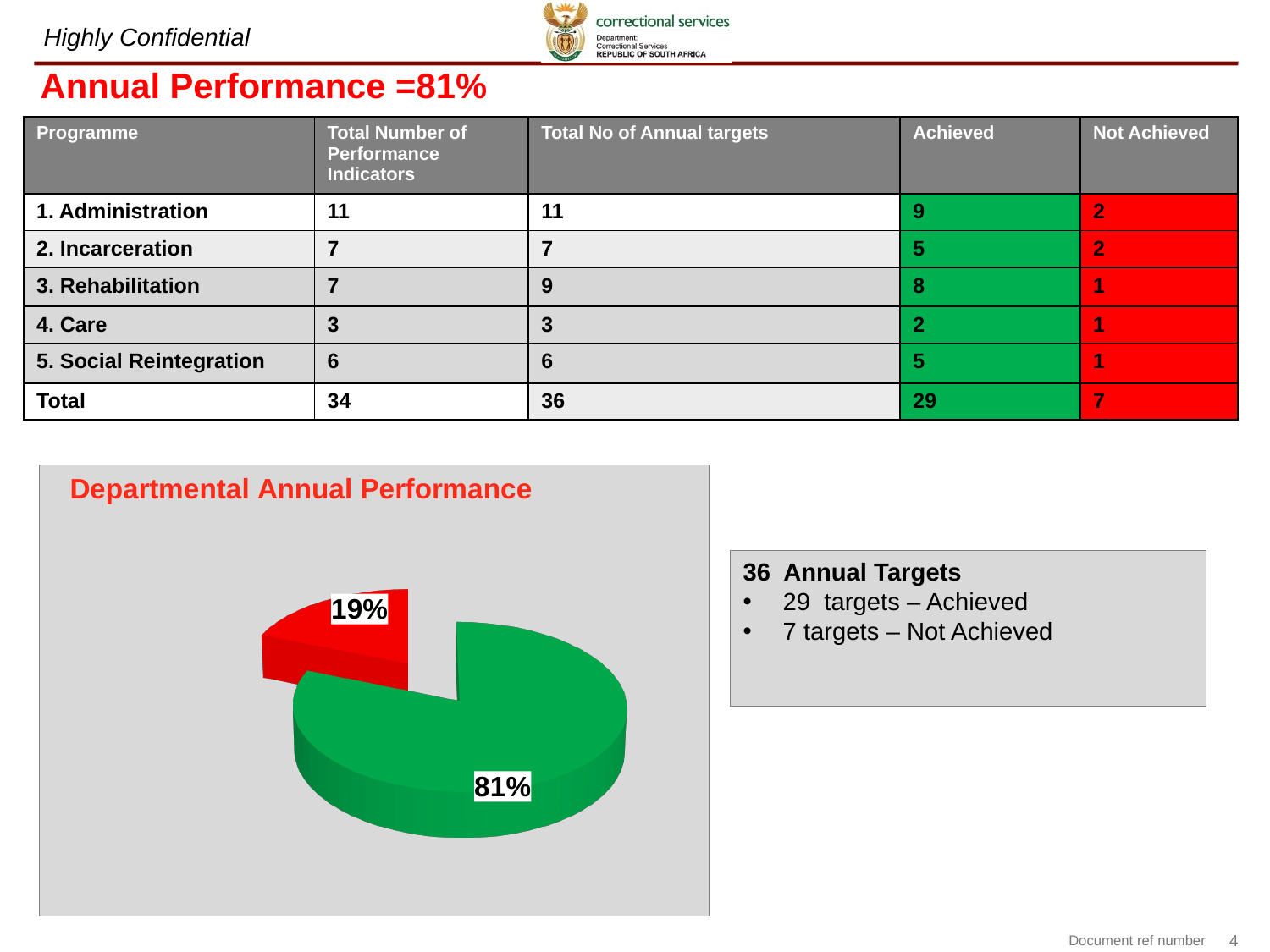
What percentage is shown on the green slice of the pie chart? 81% What is the title of the chart on the slide? Departmental Annual Performance What colour is the slice labelled 81% in the pie chart? green What is the difference in percentage points between the green slice and the red slice of the pie chart? 62 Is the green slice of the pie chart larger or smaller than the red slice? larger Which slice of the pie chart is the smallest, the green one or the red one? red How many slices does the pie chart have? 2 What share of the pie does the red slice represent? 19% Which slice of the pie chart is the largest, the green one or the red one? green What kind of chart is shown under the title "Departmental Annual Performance"? pie chart What percentage is shown on the red slice of the pie chart? 19%